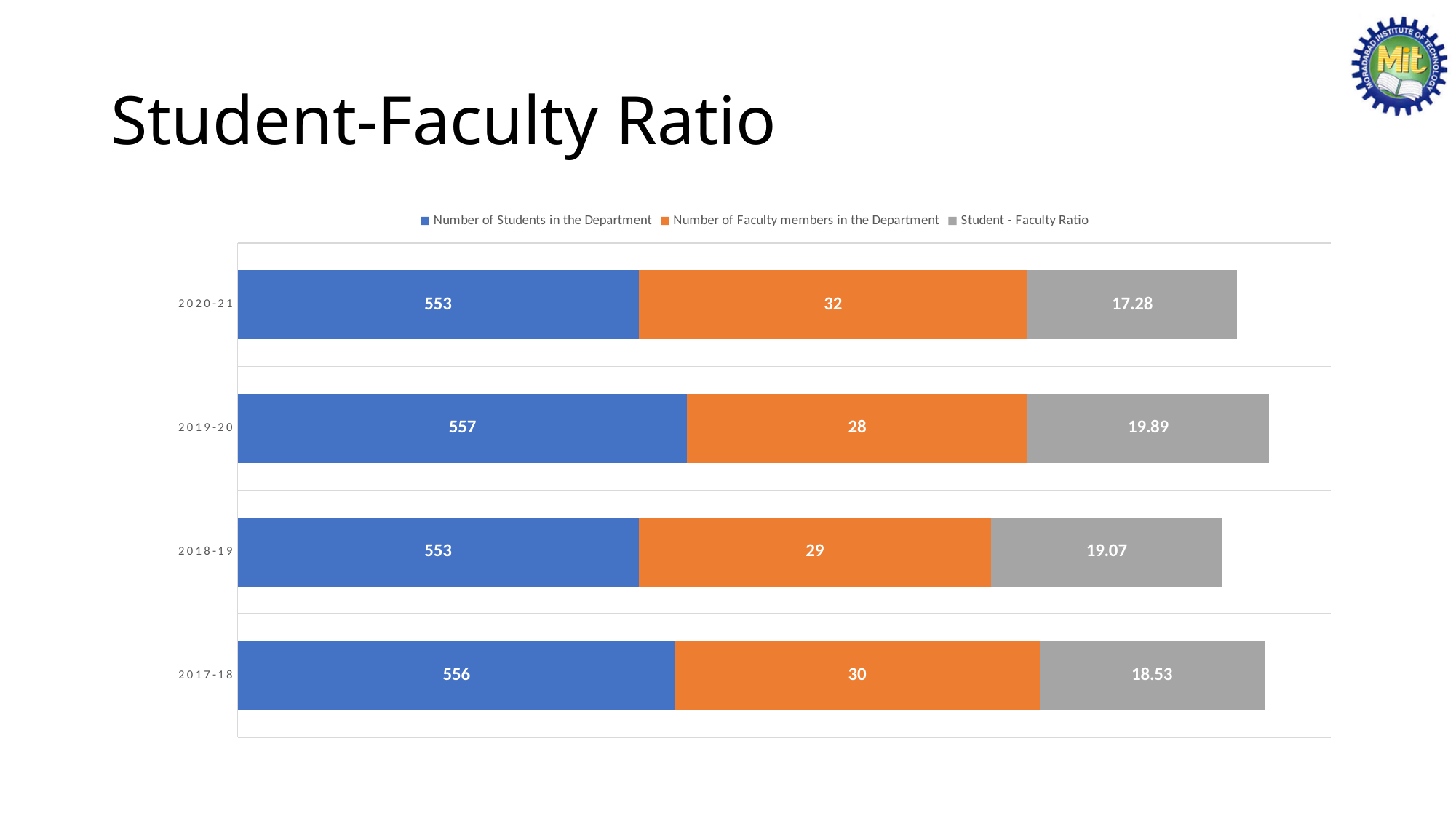
What is the Number of Faculty members in the Department for 2017-18? 30 How many series does the legend list? 3 Which year has the highest Number of Faculty members in the Department? 2020-21 Which year has the highest Student - Faculty Ratio? 2019-20 What is the difference in the Number of Faculty members in the Department between 2020-21 and 2019-20? 4 What kind of chart is shown on the slide? Stacked bar chart Which colour represents the Student - Faculty Ratio series? Grey Which year has the lowest Student - Faculty Ratio? 2020-21 How many years are shown on the chart? 4 Which year has more students in the department, 2019-20 or 2017-18? 2019-20 What is the Number of Students in the Department for 2019-20? 557 What is the Student - Faculty Ratio for 2018-19? 19.07